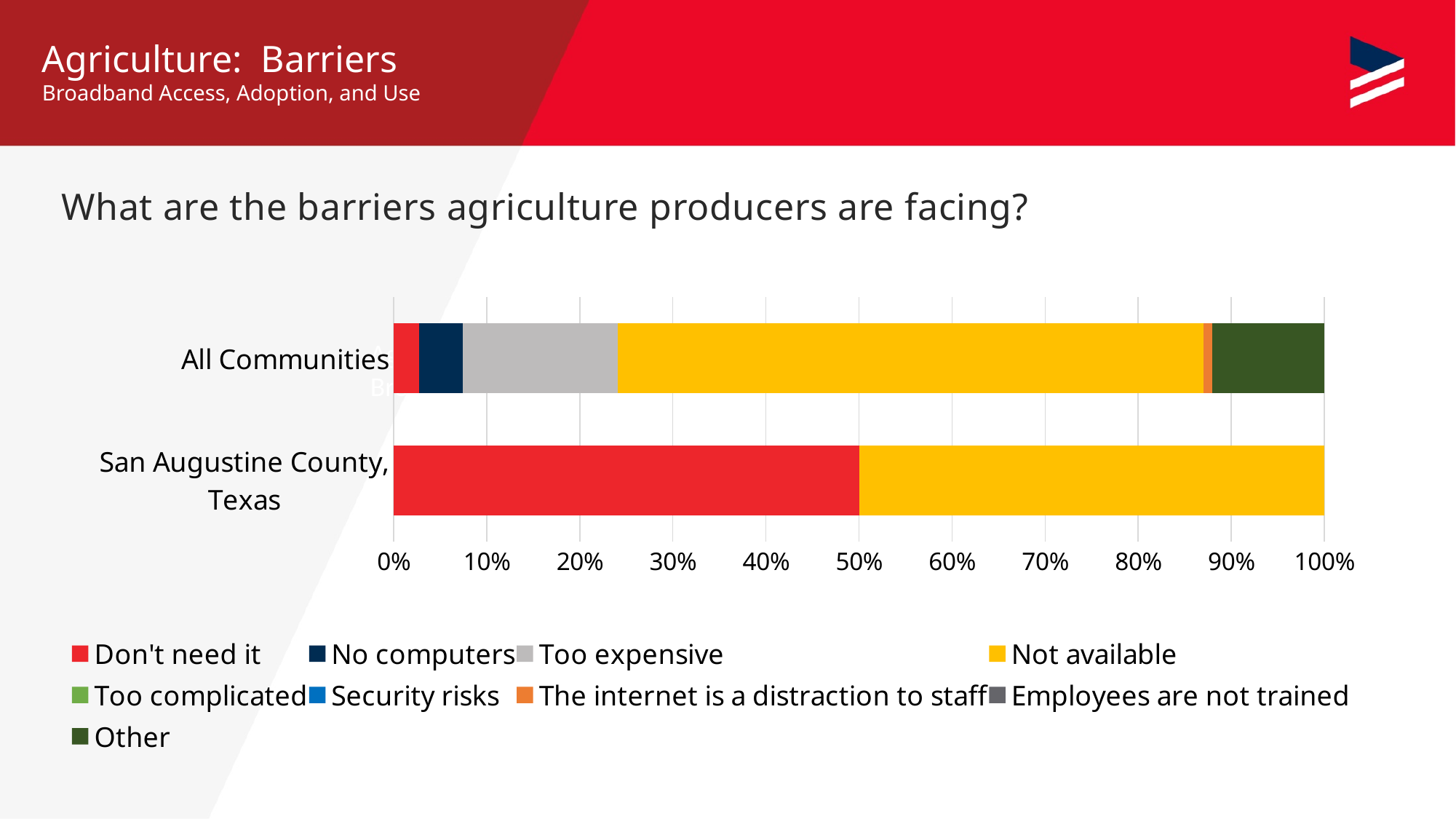
How many categories (bars) does the chart show? 2 What colour represents "Not available" in the chart? yellow Is the "Don't need it" value for All Communities greater or less than 10%? less Which category has the larger "Don't need it" segment, All Communities or San Augustine County, Texas? San Augustine County, Texas What share of San Augustine County, Texas producers cited "Not available" as a barrier? 50% What share of San Augustine County, Texas producers cited "Don't need it" as a barrier? 50% How many series does the legend list? 9 Which category has the larger "Not available" segment, All Communities or San Augustine County, Texas? All Communities What kind of chart is shown on the slide? stacked bar chart Which barrier makes up the largest segment of the All Communities bar? Not available Is the "Not available" value for All Communities greater or less than 50%? greater Is the "Too expensive" value for All Communities greater or less than 20%? less